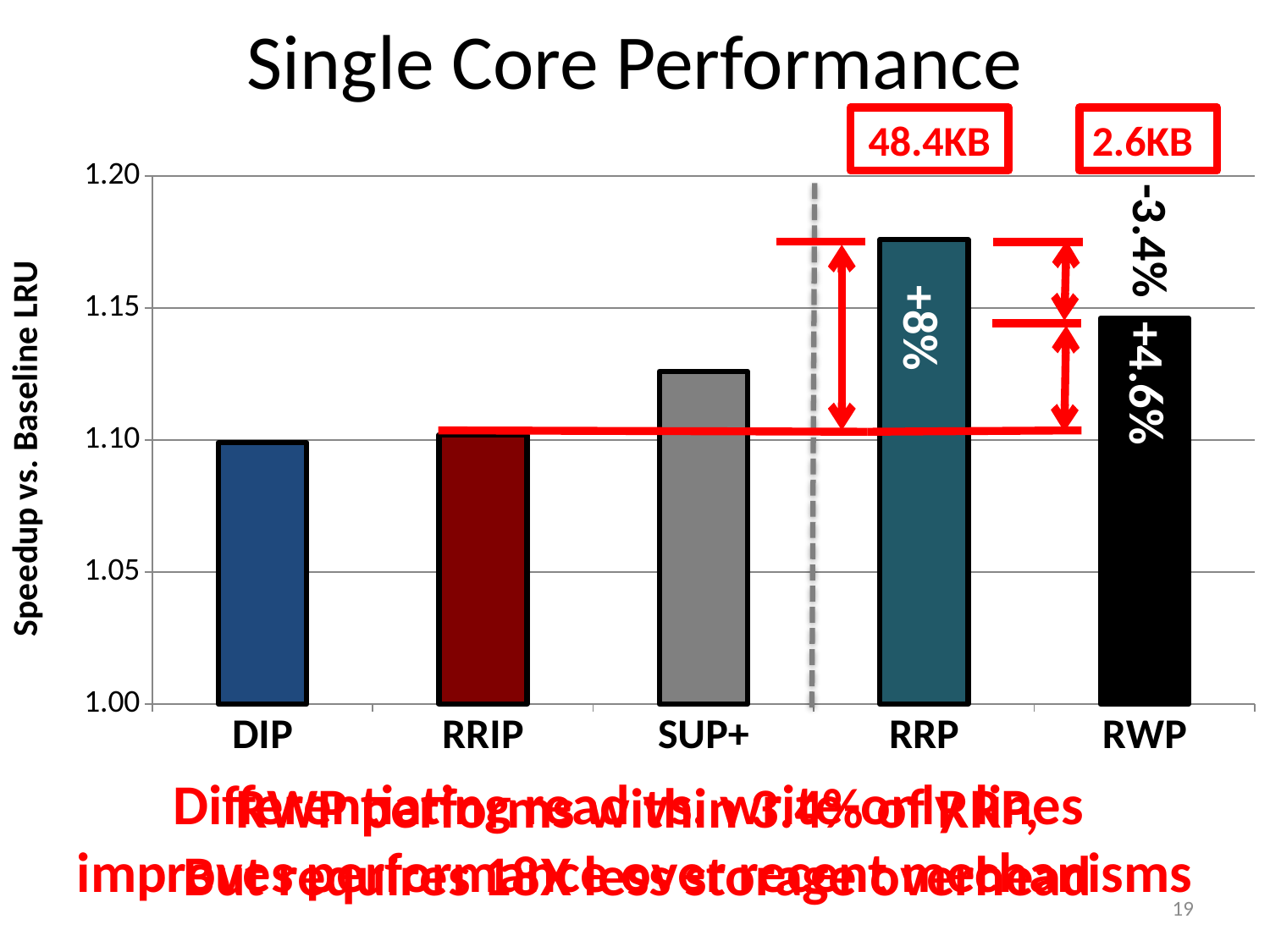
What kind of chart is shown on the slide? bar chart Which is larger, the value for DIP or the value for SUP+? SUP+ Is the value for SUP+ greater or less than 1.10? greater What storage size is annotated above the RWP bar? 2.6KB Is the value for RRP greater or less than 1.15? greater Is the value for DIP greater or less than 1.15? less What is the label of the y axis? Speedup vs. Baseline LRU How many categories are plotted on the x axis? 5 Which is larger, the value for RRP or the value for RWP? RRP Which is larger, the value for SUP+ or the value for RWP? RWP Which category has the highest speedup? RRP